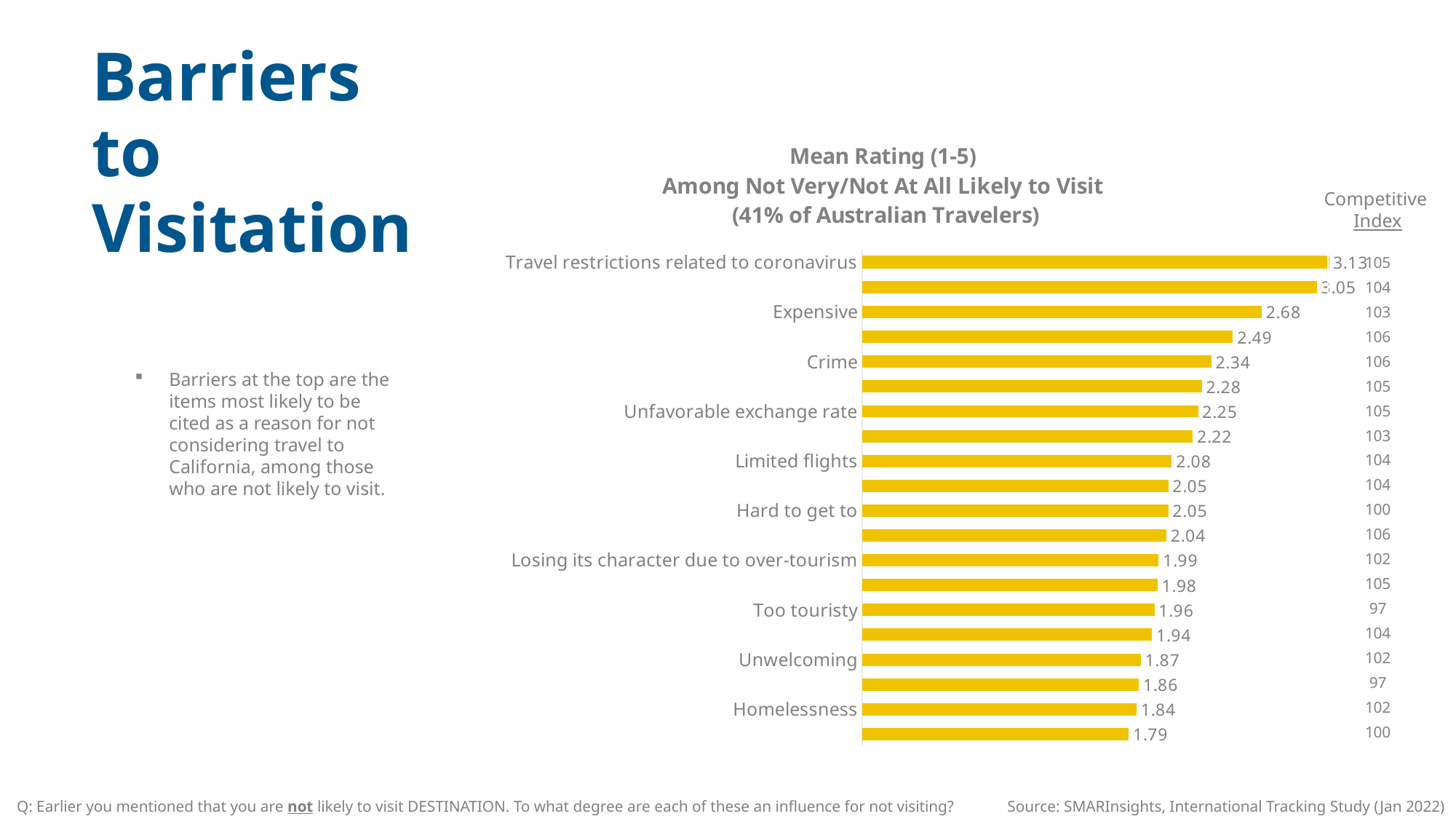
Do the mean ratings increase or decrease going from the top bar to the bottom bar? Decrease What is the mean rating for Homelessness? 1.84 What is the Competitive Index value listed for Too touristy? 97 What is the mean rating for Expensive? 2.68 What is the mean rating for Unfavorable exchange rate? 2.25 What is the difference between the mean ratings for Expensive and Crime? 0.34 Which barrier has the highest mean rating? Travel restrictions related to coronavirus How many bars are plotted on the chart? 20 What kind of chart is shown on the slide? Bar chart What is the lowest mean rating shown on the chart? 1.79 What is the mean rating for Travel restrictions related to coronavirus? 3.13 Which has a higher mean rating, Limited flights or Too touristy? Limited flights